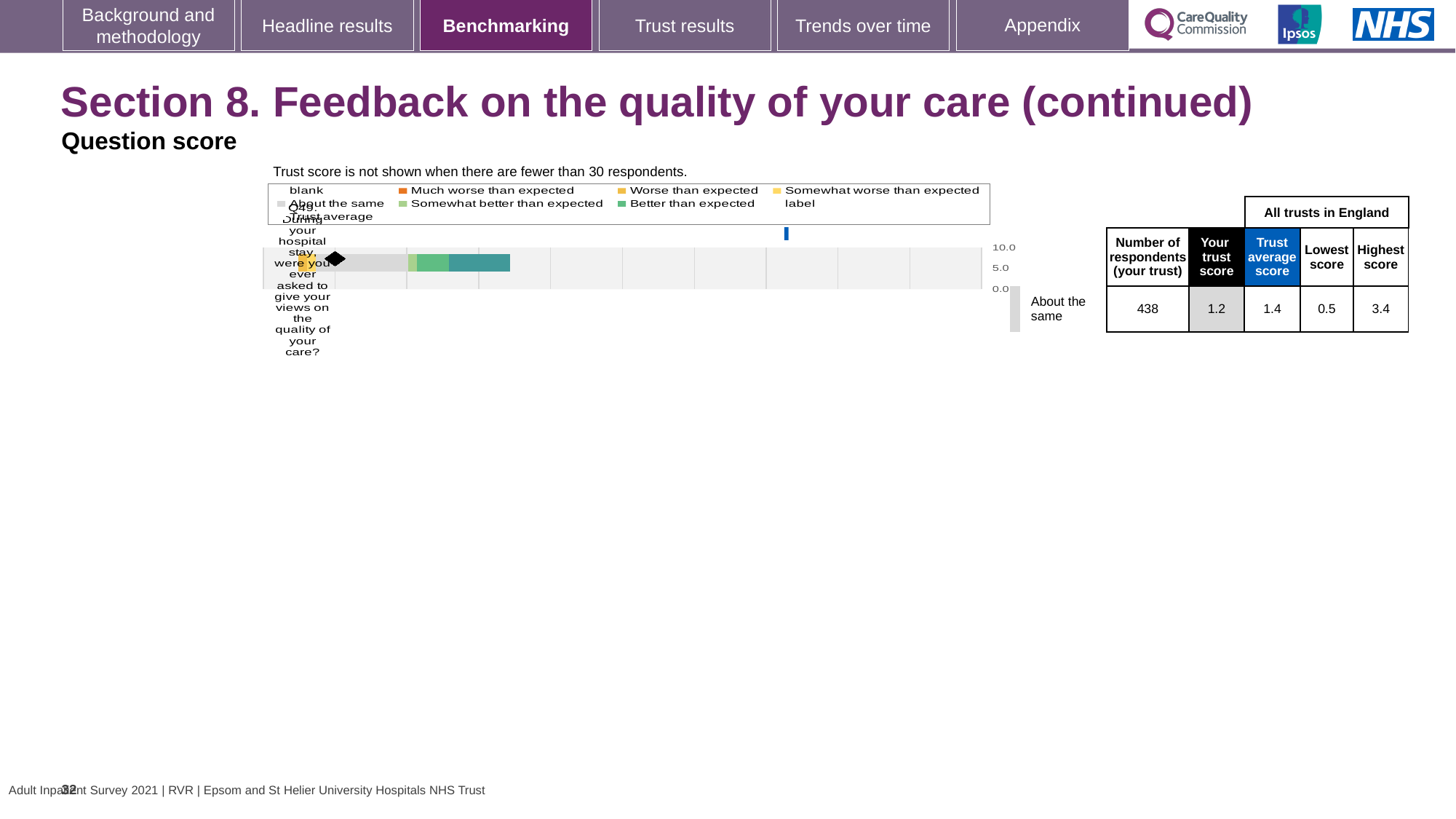
Which is larger for Q49: your trust score or the trust average score? trust average score According to the table next to the chart, what is the number of respondents for your trust for Q49? 438 What benchmark category is shown for Q49 next to the chart? About the same What is the difference between the highest score and the lowest score for Q49 in the table? 2.9 According to the table next to the chart, what is your trust score for Q49? 1.2 What colour does the legend use for 'Much worse than expected'? orange Which question is plotted in the chart? Q49. During your hospital stay, were you ever asked to give your views on the quality of your care? What kind of chart is shown on the slide? bar chart According to the table next to the chart, what is the trust average score for Q49? 1.4 According to the table next to the chart, what is the highest score among all trusts in England for Q49? 3.4 According to the table next to the chart, what is the lowest score among all trusts in England for Q49? 0.5